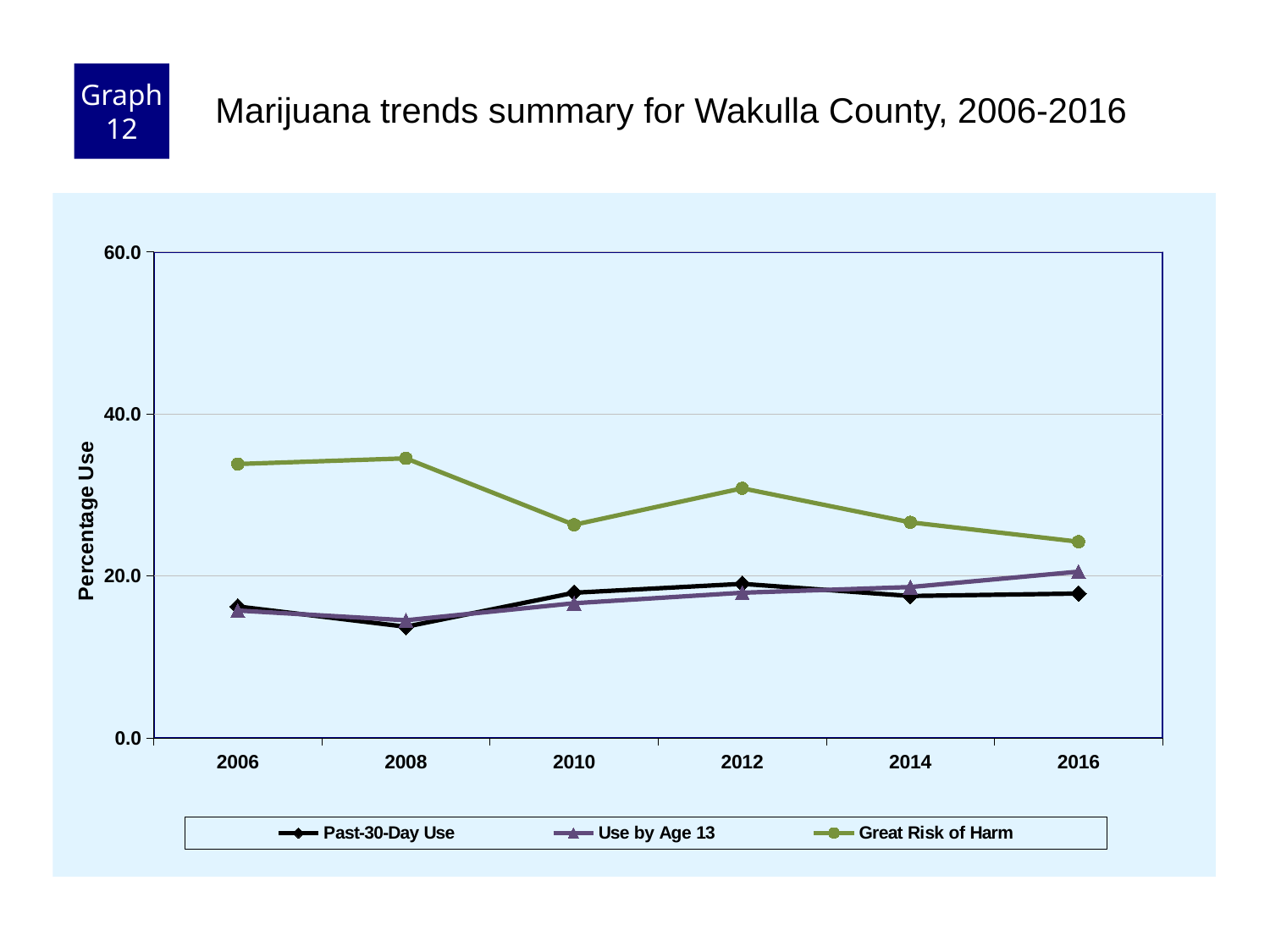
What kind of chart is shown on the slide? line chart Is the value for Great Risk of Harm in 2006 greater or less than 40.0? less In which year is Past-30-Day Use at its lowest? 2008 What is the label on the y axis? Percentage Use In 2010, which is larger: Great Risk of Harm or Past-30-Day Use? Great Risk of Harm How many years are plotted along the x axis? 6 Does the Great Risk of Harm line rise or fall overall from 2006 to 2016? fall How many series does the legend list? 3 Is the value for Past-30-Day Use in 2008 greater or less than 20.0? less Which series is plotted with the green line? Great Risk of Harm In which year is Great Risk of Harm at its lowest? 2016 Is the value for Great Risk of Harm in 2008 greater or less than 20.0? greater